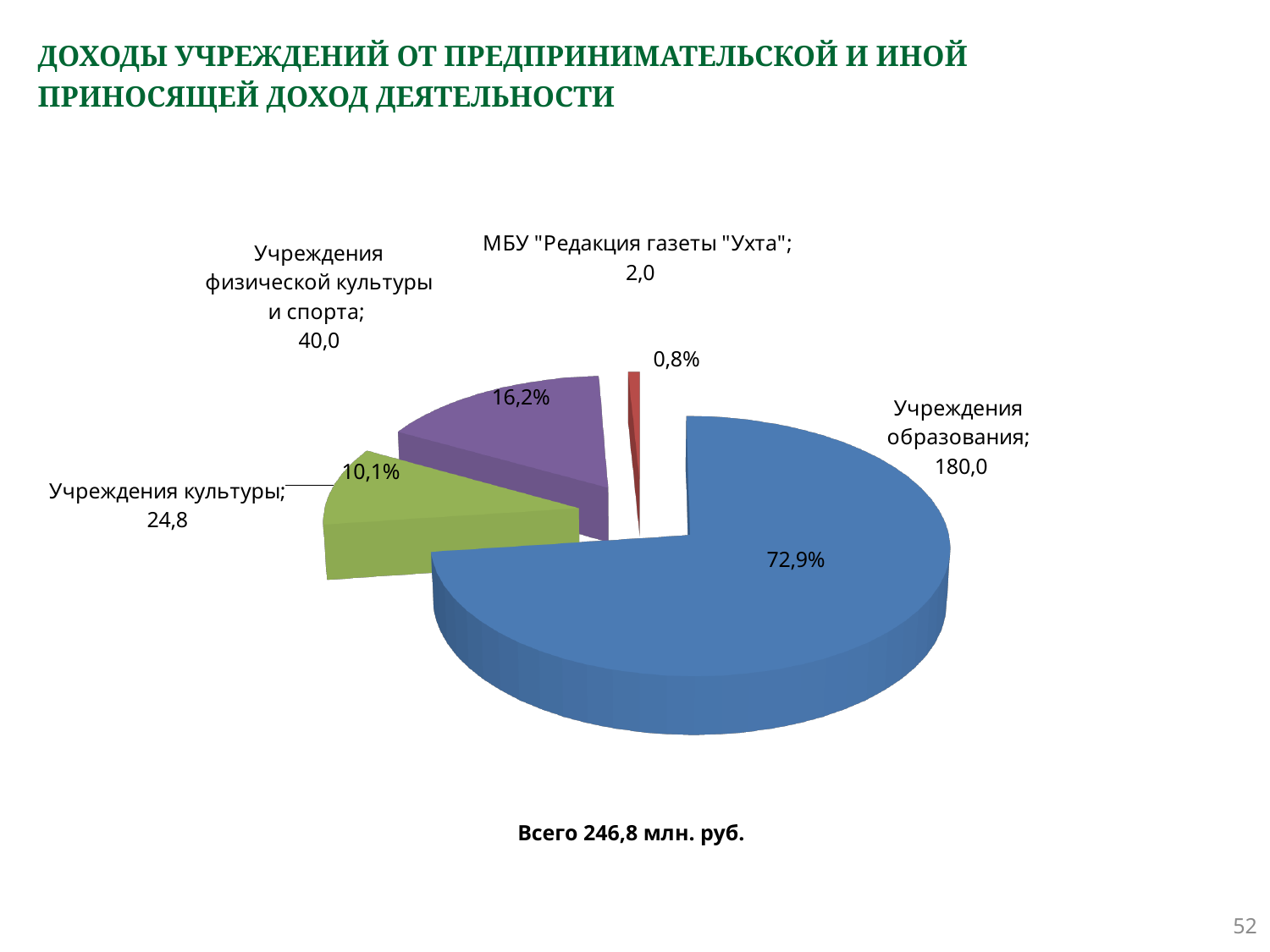
What is the difference between the values for Учреждения физической культуры и спорта and Учреждения культуры? 15,2 What share of the pie does Учреждения образования represent? 72,9% What is the value for Учреждения физической культуры и спорта? 40,0 What total is stated below the chart? 246,8 млн. руб. How many slices does the pie chart have? 4 What is the value for Учреждения культуры? 24,8 What is the value for Учреждения образования? 180,0 Which category has the smallest slice? МБУ "Редакция газеты "Ухта" What share of the pie does Учреждения культуры represent? 10,1% Which category has the largest slice? Учреждения образования What type of chart is shown on the slide? Pie chart What is the value for МБУ "Редакция газеты "Ухта"? 2,0